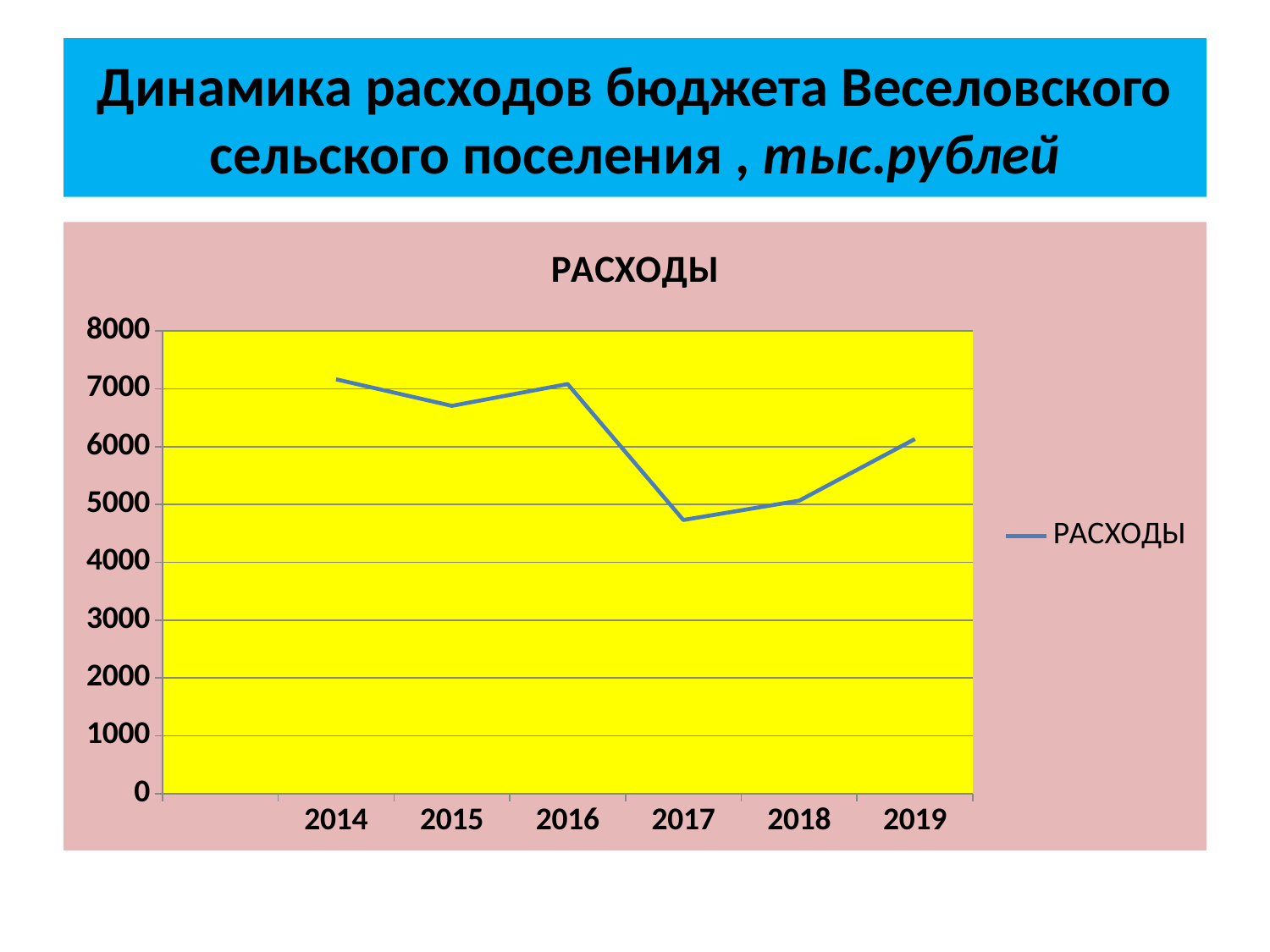
Is the value for 2014 greater or less than 7000? greater Which is larger, the value for 2015 or the value for 2017? 2015 Do the values rise or fall from 2016 to 2017? fall Which is larger, the value for 2018 or the value for 2019? 2019 What kind of chart is shown on the slide? line chart How many years are plotted on the x axis of the chart? 6 Is the value for 2015 greater or less than 7000? less Which year has the lowest value for РАСХОДЫ? 2017 How many series does the legend of the chart list? 1 Is the value for 2019 greater or less than 6000? greater What is the title of the chart? РАСХОДЫ